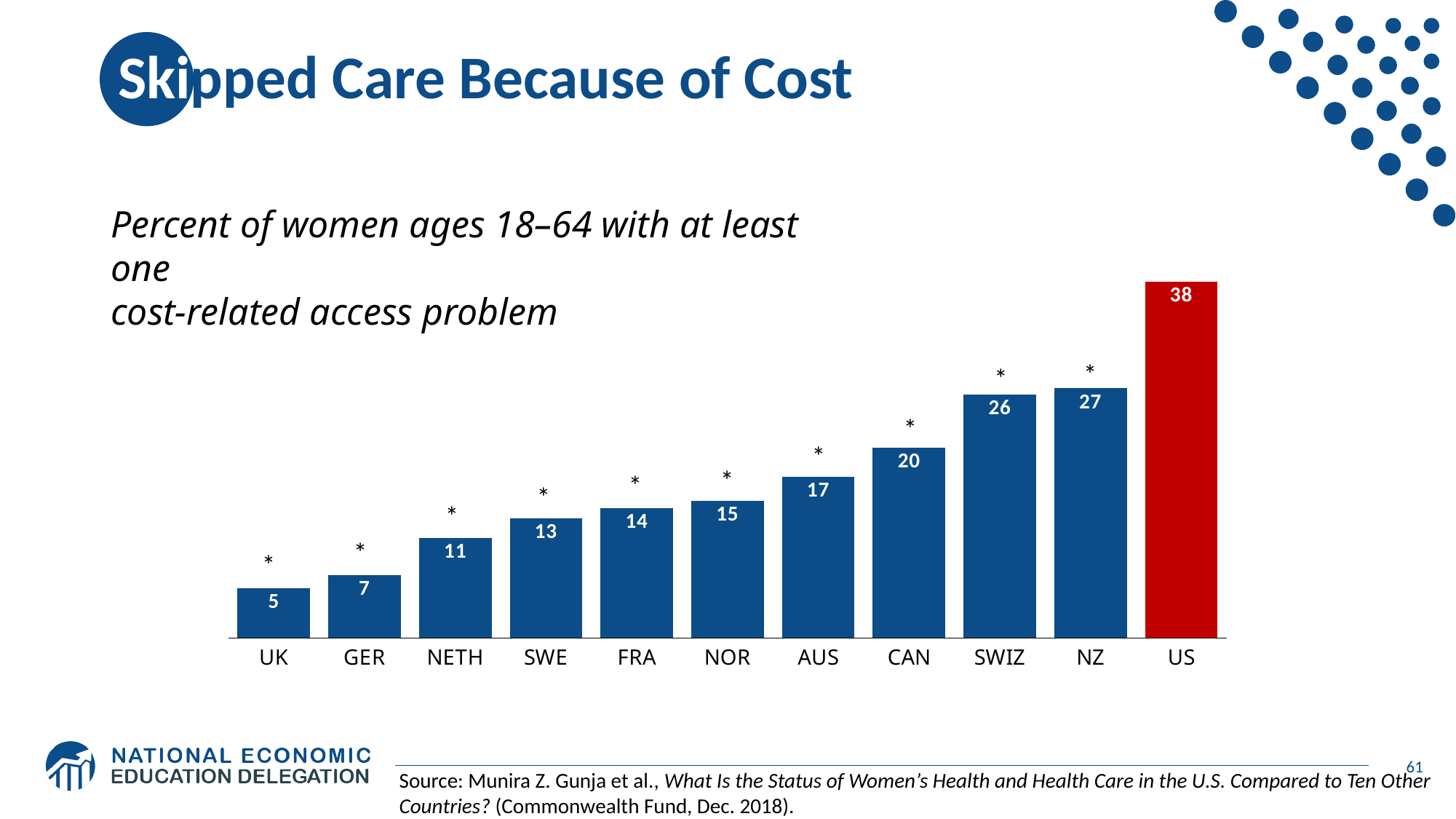
Do the values rise or fall from left to right across the countries? Rise What is the difference between the values for SWIZ and UK? 21 How many countries are shown in the chart? 11 Which country has the highest value? US Which bar is coloured red rather than blue? US What is the value for GER? 7 What is the difference between the values for the US and NZ? 11 What kind of chart is shown on the slide? Bar chart Which has a larger value, AUS or NOR? AUS What is the value for CAN? 20 Which country has the lowest value? UK What is the value for the US? 38